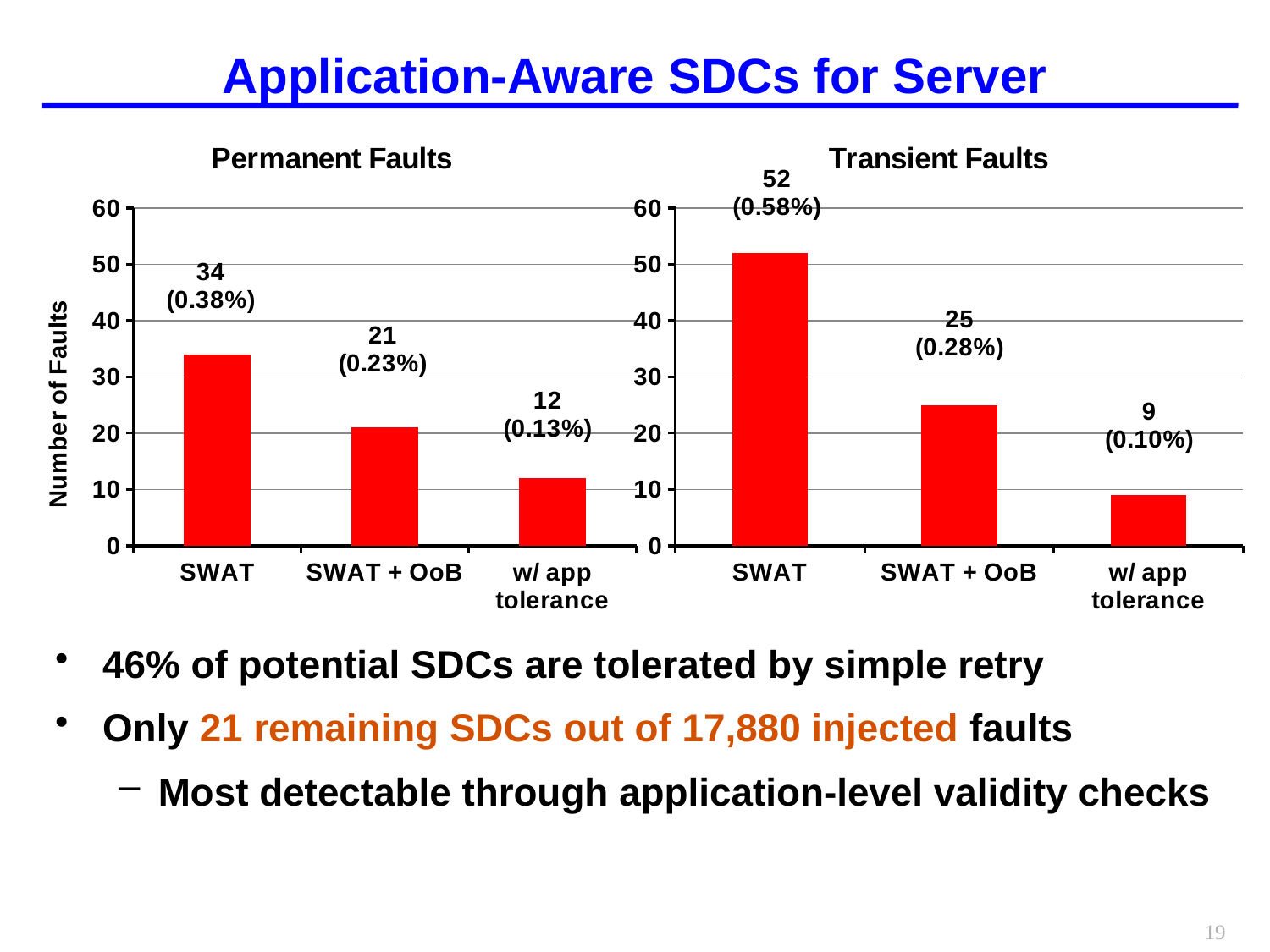
What kind of chart is the Transient Faults chart? Bar chart How many categories are shown on the x axis of the Permanent Faults chart? 3 In the Permanent Faults chart, which category has the lowest number of faults? w/ app tolerance In the Permanent Faults chart, do the values rise or fall from left to right along the x axis? Fall In the Permanent Faults chart, what is the number of faults for SWAT? 34 In the Transient Faults chart, what percentage is shown in parentheses for SWAT? 0.58% In the Transient Faults chart, what is the difference in number of faults between SWAT and SWAT + OoB? 27 Which is larger: the SWAT value in the Permanent Faults chart or the SWAT value in the Transient Faults chart? Transient Faults In the Transient Faults chart, what is the number of faults for w/ app tolerance? 9 In the Permanent Faults chart, what is the number of faults for SWAT + OoB? 21 In the Transient Faults chart, which category has the highest number of faults? SWAT In the Permanent Faults chart, what is the difference in number of faults between SWAT + OoB and w/ app tolerance? 9